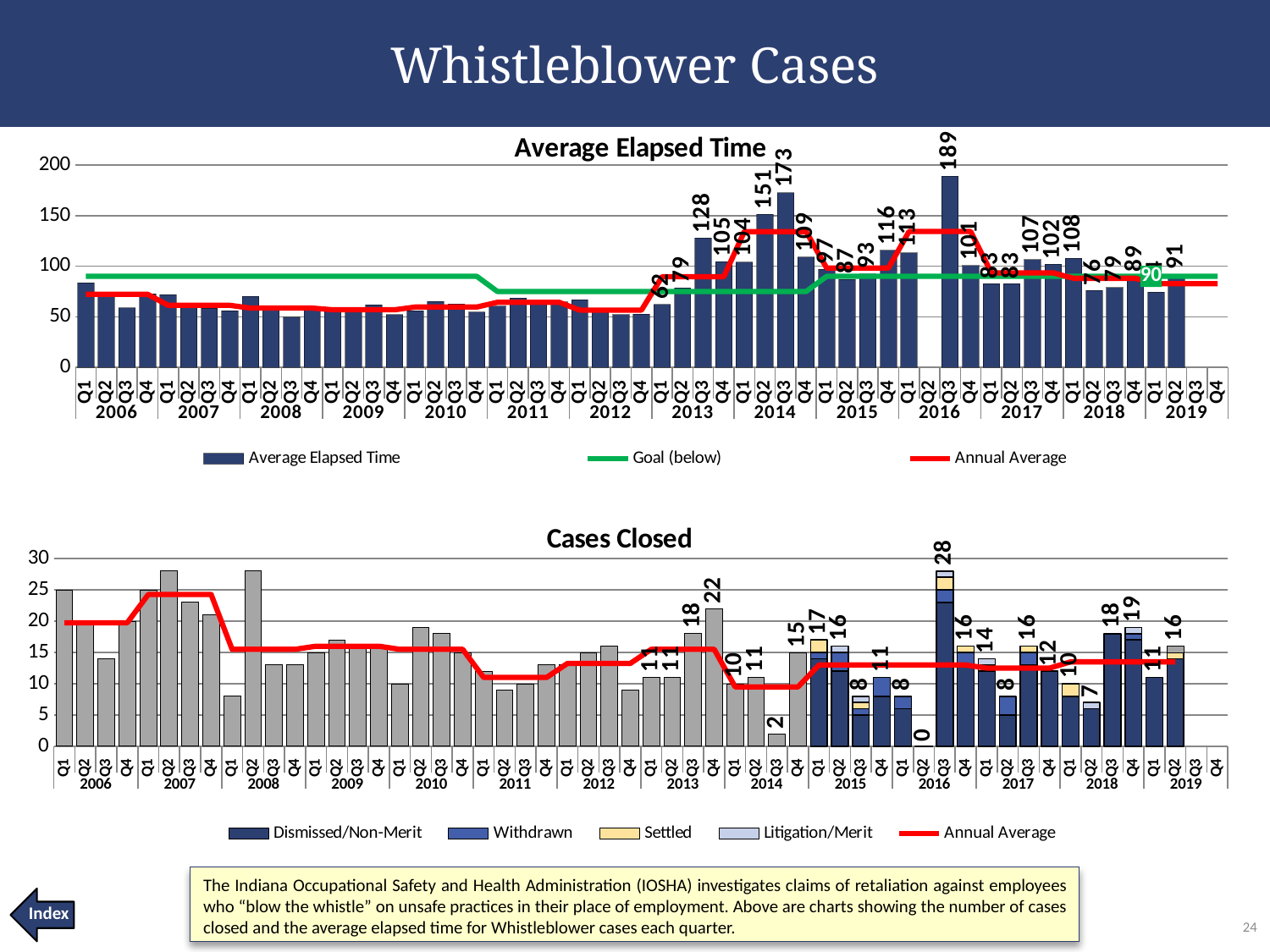
In the Average Elapsed Time chart, what is the value for Q1 2013? 62 In the Cases Closed chart, what is the value for Q3 2014? 2 How many series does the legend of the Cases Closed chart list? 5 In the Average Elapsed Time chart, what kind of chart is used to show the quarterly values? bar chart In the Average Elapsed Time chart, is the value for Q1 2006 greater or less than 100? less In the Cases Closed chart, what is the value for Q3 2016? 28 In the Average Elapsed Time chart, which is larger, the value for Q3 2013 or the value for Q4 2015? Q3 2013 In the Average Elapsed Time chart, what is the value for Q3 2014? 173 In the Cases Closed chart, what is the difference between the values for Q4 2018 and Q2 2018? 12 In the Average Elapsed Time chart, what is the difference between the values for Q3 2014 and Q4 2014? 64 How many series does the legend of the Average Elapsed Time chart list? 3 In the Average Elapsed Time chart, which quarter has the highest average elapsed time? Q3 2016